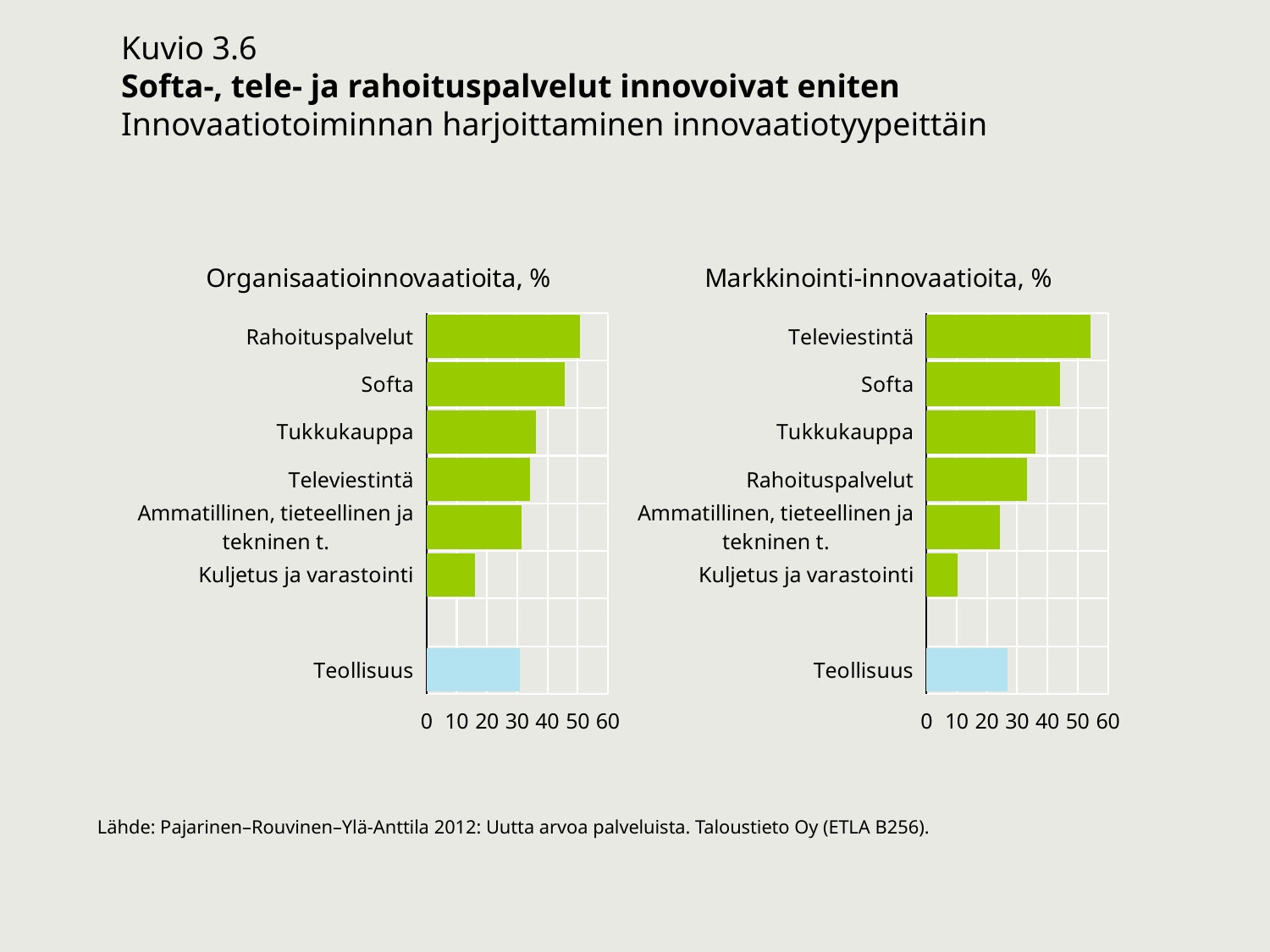
In the right chart "Markkinointi-innovaatioita, %", which category has the lowest value? Kuljetus ja varastointi What kind of chart is the left chart titled "Organisaatioinnovaatioita, %"? bar chart In the right chart "Markkinointi-innovaatioita, %", is the value for Ammatillinen, tieteellinen ja tekninen t. greater or less than 30? less In the right chart "Markkinointi-innovaatioita, %", is the value for Televiestintä greater or less than 50? greater In the left chart "Organisaatioinnovaatioita, %", is the value for Kuljetus ja varastointi greater or less than 20? less In the left chart "Organisaatioinnovaatioita, %", which category has the lowest value? Kuljetus ja varastointi How many categories are shown in the left chart "Organisaatioinnovaatioita, %"? 7 In the left chart "Organisaatioinnovaatioita, %", what colour is the bar for Teollisuus? light blue In the left chart "Organisaatioinnovaatioita, %", which category has the highest value? Rahoituspalvelut In the right chart "Markkinointi-innovaatioita, %", which category has the highest value? Televiestintä In the right chart "Markkinointi-innovaatioita, %", which is larger, the value for Televiestintä or the value for Softa? Televiestintä